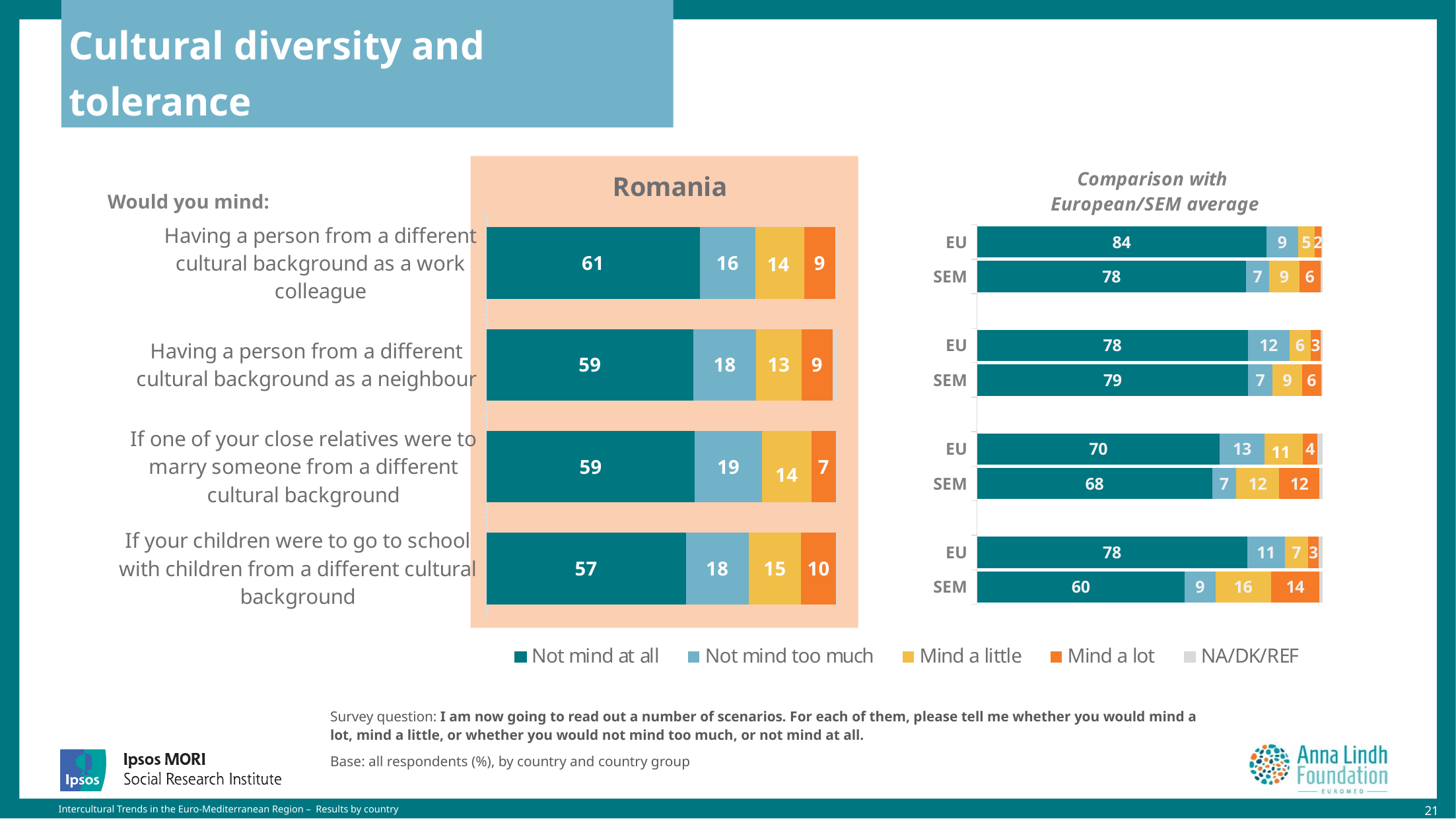
In the Romania chart, what percentage would not mind at all having a person from a different cultural background as a work colleague? 61 In the Comparison with European/SEM average chart, which is larger for the marriage scenario: the EU 'Not mind at all' value or the SEM 'Not mind at all' value? EU In the Romania chart, which scenario has the highest 'Not mind at all' value? Having a person from a different cultural background as a work colleague In the Comparison with European/SEM average chart, what is the EU 'Not mind at all' value for the work colleague scenario? 84 In the Comparison with European/SEM average chart, what is the SEM 'Mind a lot' value for the school scenario? 14 In the Romania chart, what is the 'Mind a lot' value for children going to school with children from a different cultural background? 10 In the Comparison with European/SEM average chart, what is the difference between the EU and SEM 'Not mind at all' values for the school scenario? 18 How many series does the legend list? 5 What kind of chart is the Romania chart? Stacked bar chart In the Romania chart, what is the difference between the 'Not mind at all' values for the work colleague scenario and the school scenario? 4 In the Romania chart, which scenario has the lowest 'Not mind at all' value? If your children were to go to school with children from a different cultural background